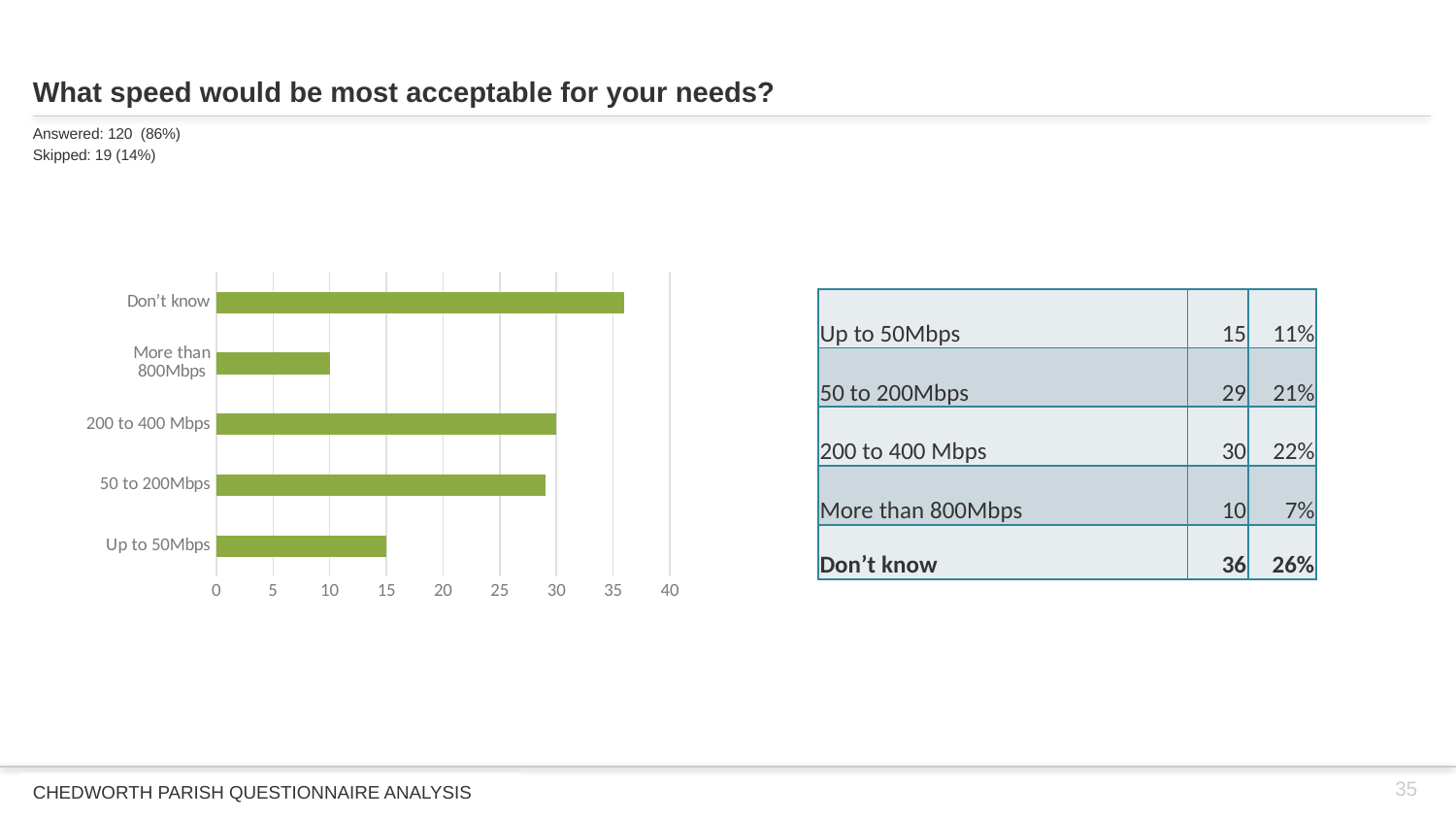
What is the value for More than 800Mbps? 10 Is the value for Don't know greater or less than 35? greater What is the value for Don't know? 36 Which category has the lowest value in the bar chart? More than 800Mbps How many categories does the bar chart show? 5 Is the value for 50 to 200Mbps greater or less than 30? less Which category has the highest value in the bar chart? Don't know What is the difference between the value for Don't know and the value for Up to 50Mbps? 21 What kind of chart is shown on the slide? bar chart What is the value for Up to 50Mbps? 15 Which is larger, the value for 200 to 400 Mbps or the value for More than 800Mbps? 200 to 400 Mbps What is the value for 200 to 400 Mbps? 30